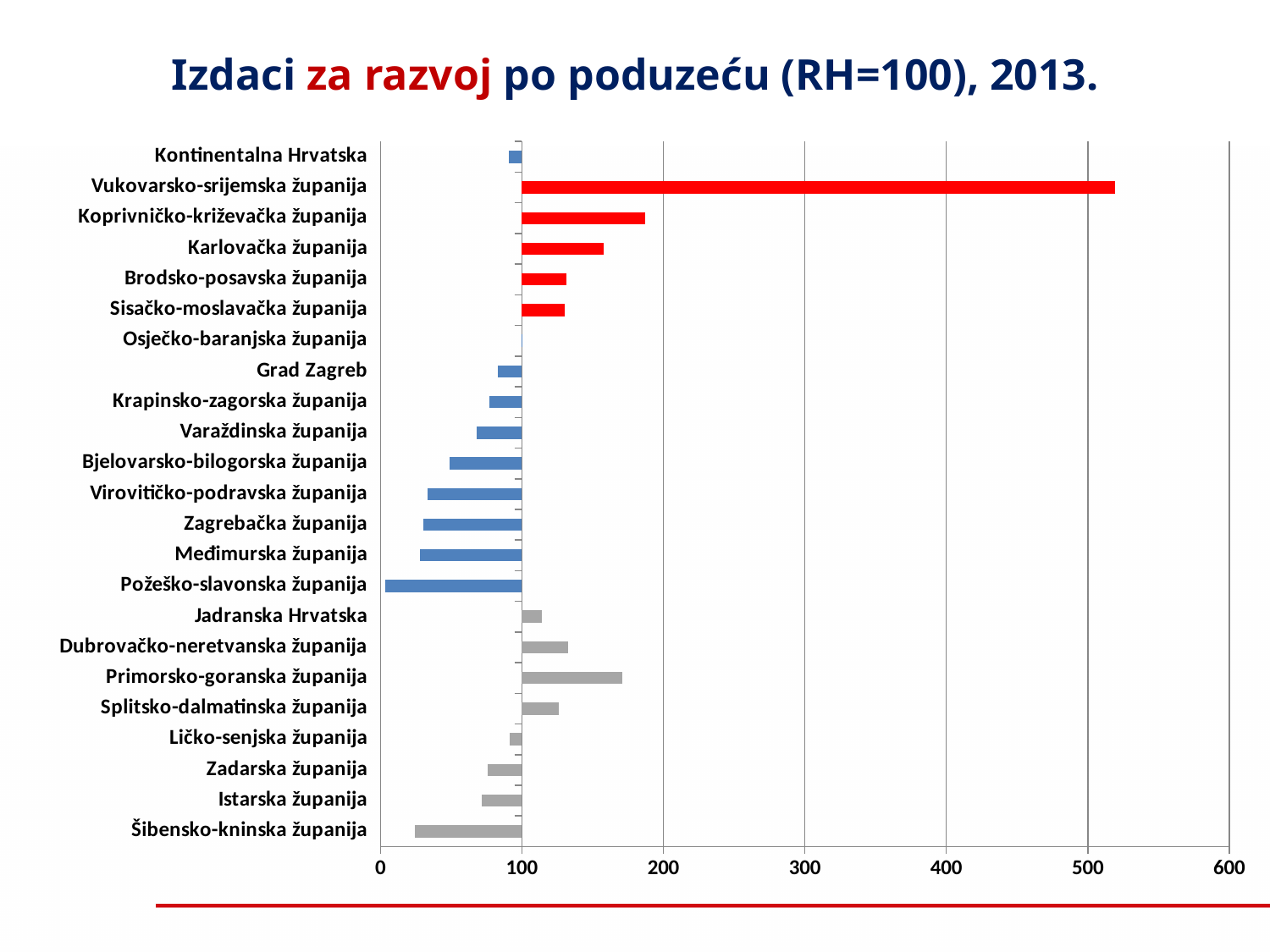
How many categories are plotted on the chart? 23 What is the title of the chart? Izdaci za razvoj po poduzeću (RH=100), 2013. Which category has the highest value? Vukovarsko-srijemska županija Which category has the lowest value? Požeško-slavonska županija Is the value for Vukovarsko-srijemska županija greater or less than 500? greater Is the value for Koprivničko-križevačka županija greater or less than 200? less What kind of chart is shown on the slide? bar chart What colour is the bar for Vukovarsko-srijemska županija? red Which is larger, the value for Primorsko-goranska županija or Splitsko-dalmatinska županija? Primorsko-goranska županija Is the value for Primorsko-goranska županija greater or less than 100? greater Which is larger, the value for Koprivničko-križevačka županija or Karlovačka županija? Koprivničko-križevačka županija